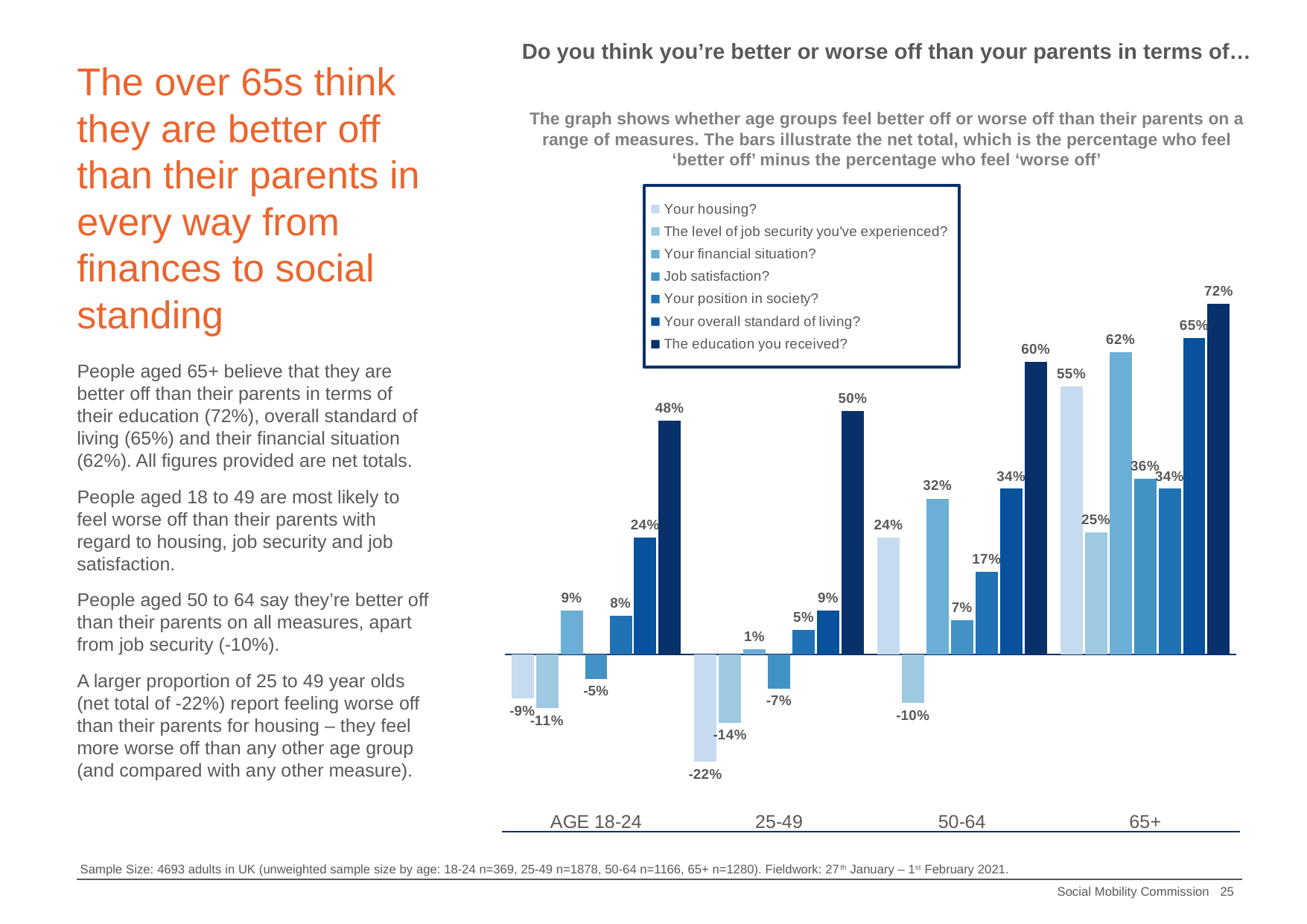
How many series does the legend list? 7 Does the net total for 'The education you received?' rise or fall as the age groups get older from 18-24 to 65+? Rises What is the net total for 'The level of job security you've experienced?' among the 50-64 age group? -10% How many age groups are shown on the x axis? 4 Which age group has the lowest net total for 'Your housing?'? 25-49 What is the net total for 'The education you received?' among the 65+ age group? 72% What is the net total for 'Your overall standard of living?' among the 18-24 age group? 24% What kind of chart is shown on the slide? Bar chart What is the difference between the 'The education you received?' net total for the 65+ group (72%) and the 18-24 group (48%)? 24 percentage points What is the net total for 'Your housing?' among the 25-49 age group? -22% Which age group has the larger net total for 'Your financial situation?': 50-64 or 65+? 65+ Which age group has the highest net total for 'The education you received?'? 65+